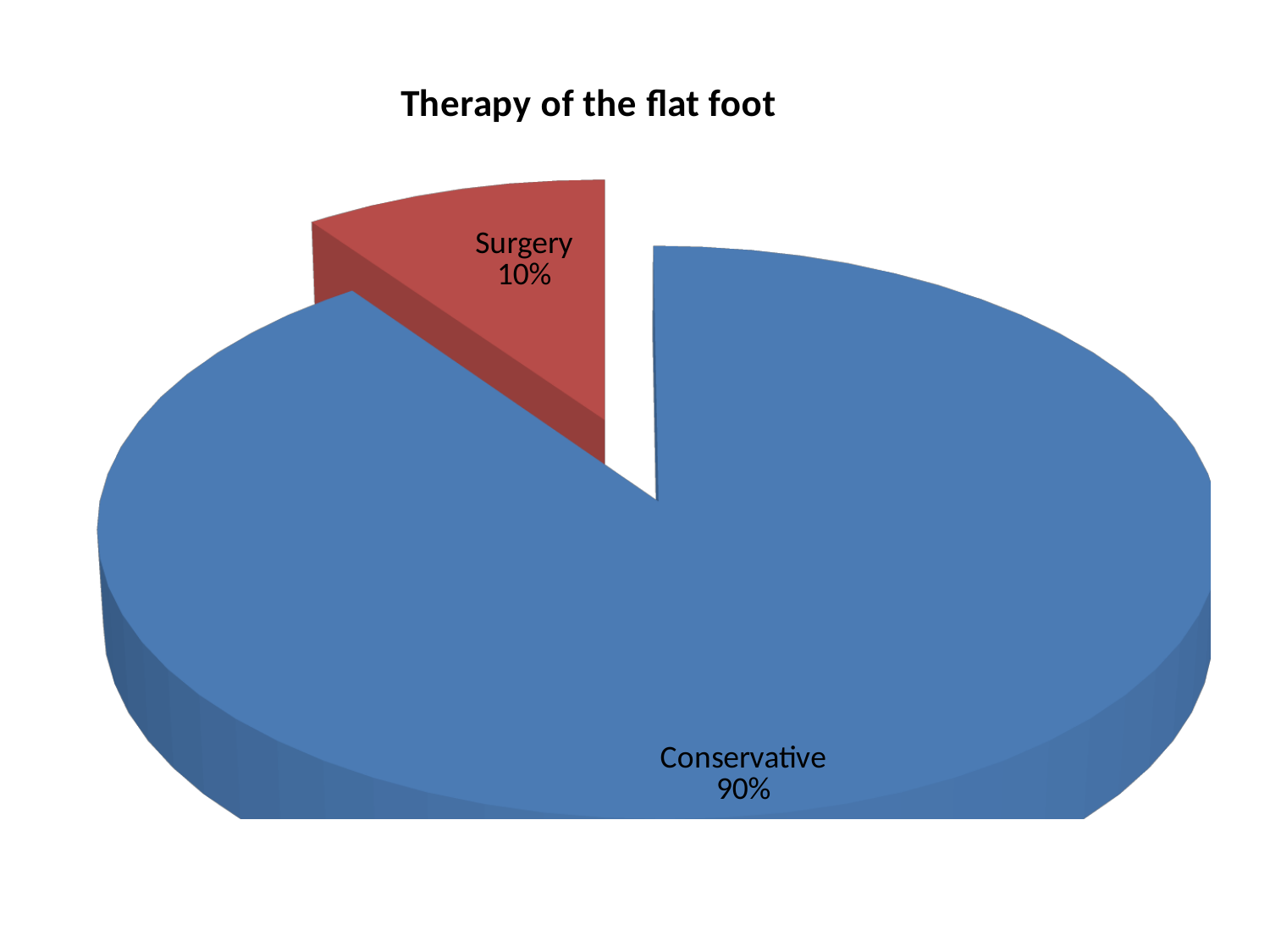
What colour is the Surgery slice? Red What is the value shown for the Conservative slice? 90% Which category has the smallest slice of the pie? Surgery What kind of chart is shown on the slide? Pie chart How many slices does the pie chart have? 2 What is the difference in percentage points between Conservative and Surgery? 80 percentage points What is the title of the chart? Therapy of the flat foot Which category has the largest slice of the pie? Conservative Which is larger, the Surgery slice or the Conservative slice? Conservative What share of the pie does Conservative represent? 90% What share of the pie does Surgery represent? 10%